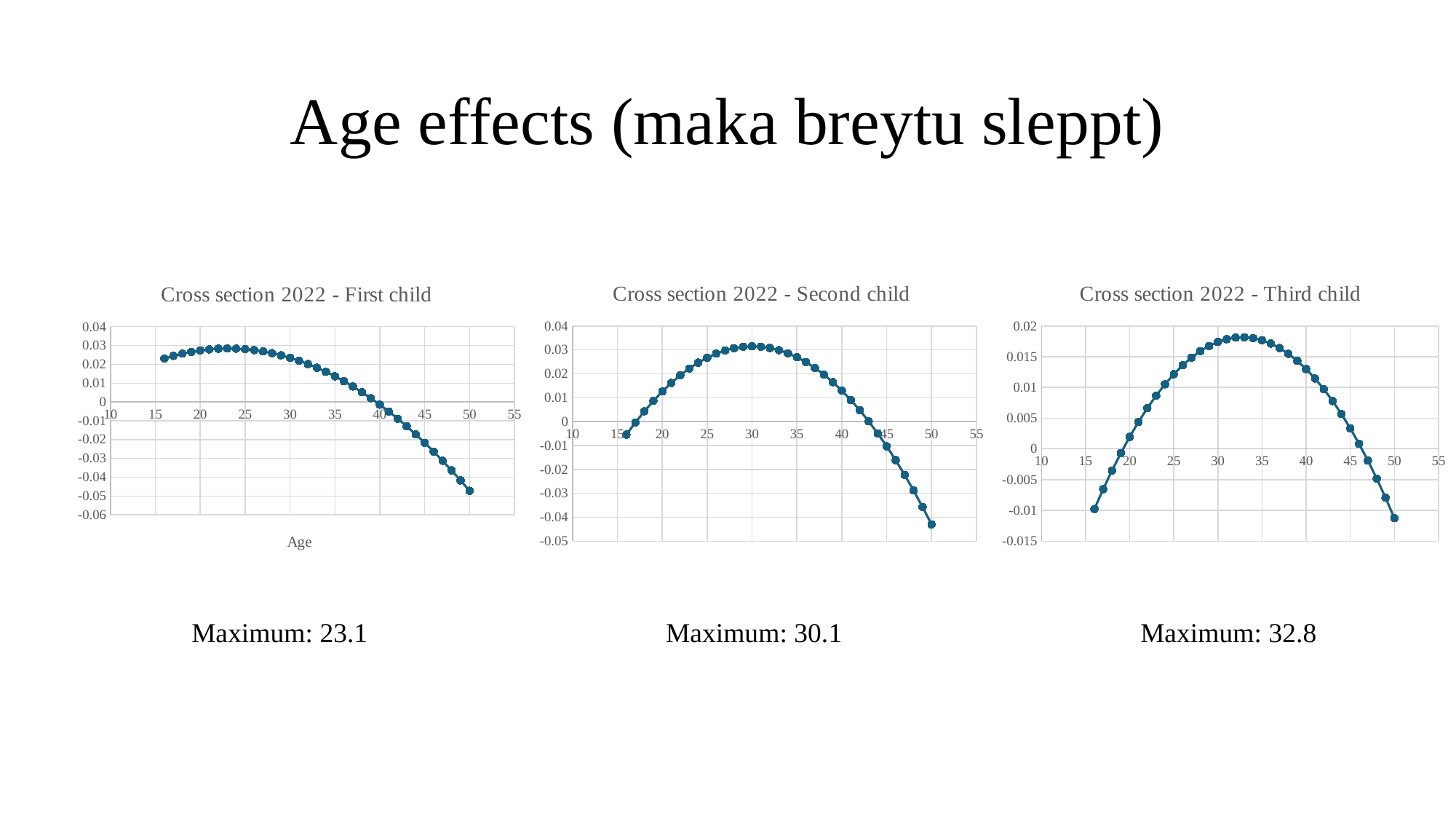
What maximum is stated below the 'Cross section 2022 - Third child' chart? 32.8 In the 'Cross section 2022 - First child' chart, is the value at age 50 greater or less than -0.04? less In the 'Cross section 2022 - Second child' chart, is the value at age 30 greater or less than 0.02? greater In the 'Cross section 2022 - First child' chart, which is larger: the value at age 20 or the value at age 45? age 20 What is the x-axis label on the 'Cross section 2022 - First child' chart? Age In the 'Cross section 2022 - Third child' chart, is the value at age 33 greater or less than 0.015? greater In the 'Cross section 2022 - First child' chart, do the values rise or fall between age 30 and age 50? fall In the 'Cross section 2022 - Second child' chart, do the values rise or fall between age 16 and age 30? rise What kind of chart is 'Cross section 2022 - First child'? line chart